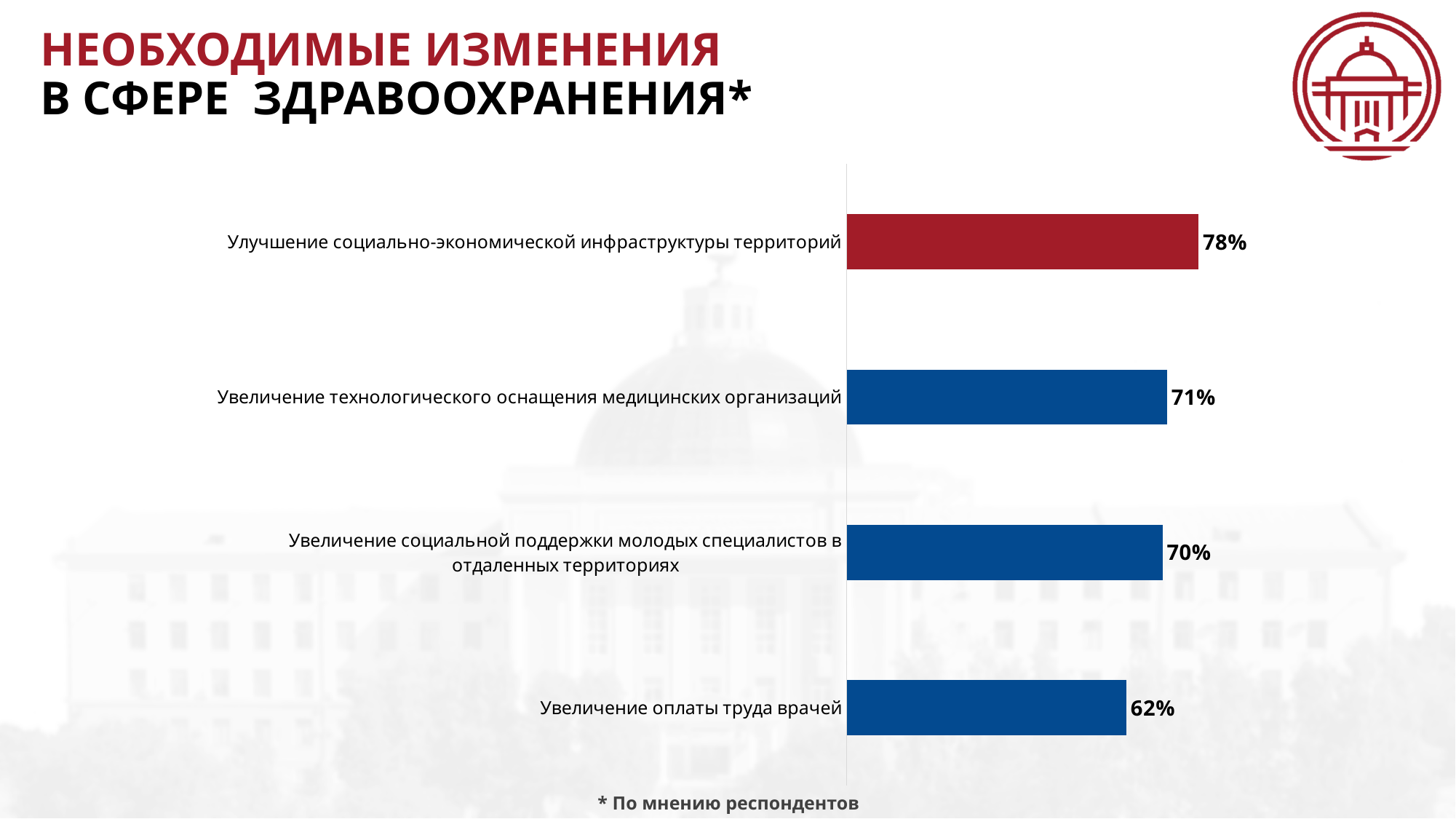
What kind of chart is shown on the slide? Bar chart What is the value for "Увеличение социальной поддержки молодых специалистов в отдаленных территориях"? 70% Which category has the highest value? Улучшение социально-экономической инфраструктуры территорий What is the difference between the values for "Увеличение технологического оснащения медицинских организаций" and "Увеличение социальной поддержки молодых специалистов в отдаленных территориях"? 1% Which is larger: the value for "Увеличение технологического оснащения медицинских организаций" or for "Увеличение оплаты труда врачей"? Увеличение технологического оснащения медицинских организаций Which category has the lowest value? Увеличение оплаты труда врачей What is the value for "Увеличение оплаты труда врачей"? 62% What is the value for "Улучшение социально-экономической инфраструктуры территорий"? 78% What is the value for "Увеличение технологического оснащения медицинских организаций"? 71% How many categories are shown in the chart? 4 What is the difference between the values for "Улучшение социально-экономической инфраструктуры территорий" and "Увеличение оплаты труда врачей"? 16% Which bar is coloured red rather than blue? Улучшение социально-экономической инфраструктуры территорий